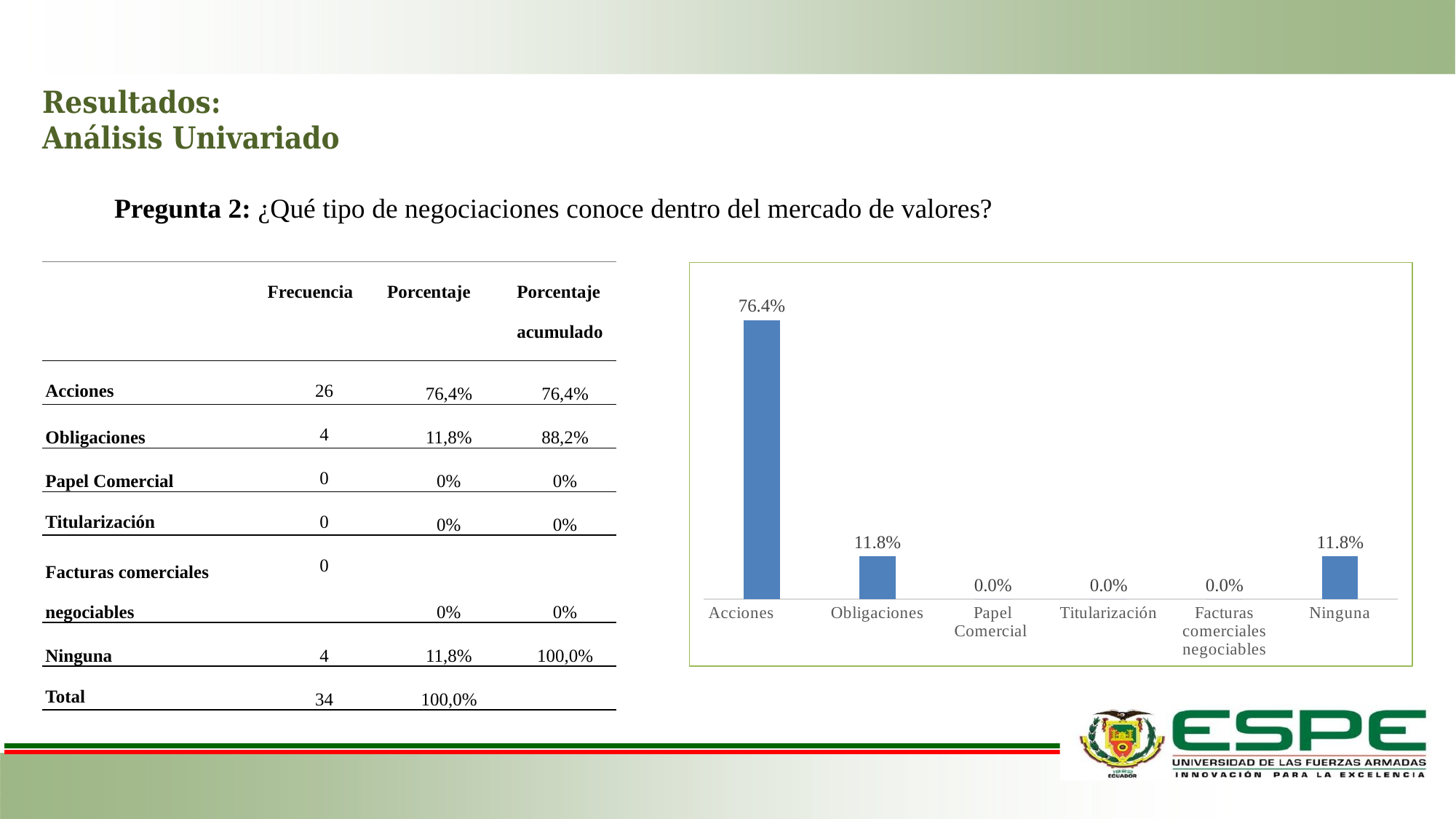
What is the value shown for Ninguna in the bar chart? 11.8% What is the value shown for Obligaciones in the bar chart? 11.8% What is the value shown for Papel Comercial in the bar chart? 0.0% Which is larger in the bar chart, the value for Acciones or the value for Ninguna? Acciones How many categories are shown on the x axis of the bar chart? 6 What is the value shown for Acciones in the bar chart? 76.4% Which category has the highest value in the bar chart? Acciones What colour are the bars in the chart? Blue What is the difference between the values for Acciones and Obligaciones in the bar chart? 64.6% What kind of chart is shown on the slide? Bar chart How many categories in the bar chart have a value of 0.0%? 3 What is the value shown for Titularización in the bar chart? 0.0%